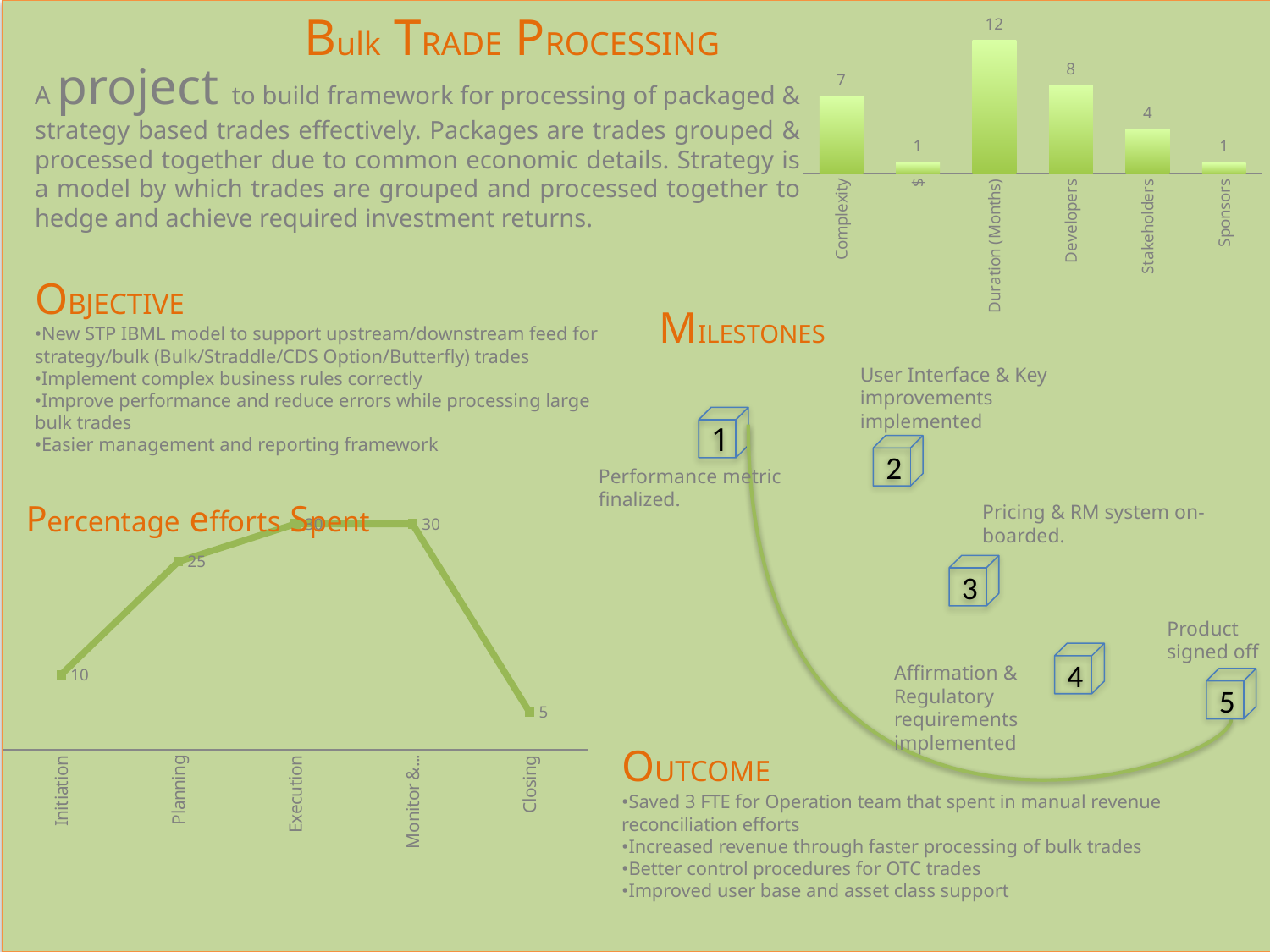
In the bar chart at the top right of the slide, which category has the highest value? Duration (Months) In the 'Percentage efforts Spent' chart, what is the value for Closing? 5 In the 'Percentage efforts Spent' chart, what is the value for Initiation? 10 In the bar chart at the top right of the slide, which is larger, the value for Developers or the value for Complexity? Developers What kind of chart is the 'Percentage efforts Spent' chart? line chart How many categories are shown in the bar chart at the top right of the slide? 6 In the bar chart at the top right of the slide, what is the value for Duration (Months)? 12 In the 'Percentage efforts Spent' chart, what is the difference between the values for Planning and Initiation? 15 In the 'Percentage efforts Spent' chart, which category has the lowest value? Closing In the bar chart at the top right of the slide, what is the difference between the values for Complexity and Stakeholders? 3 In the bar chart at the top right of the slide, what is the value for Developers? 8 What kind of chart is the chart at the top right of the slide? bar chart